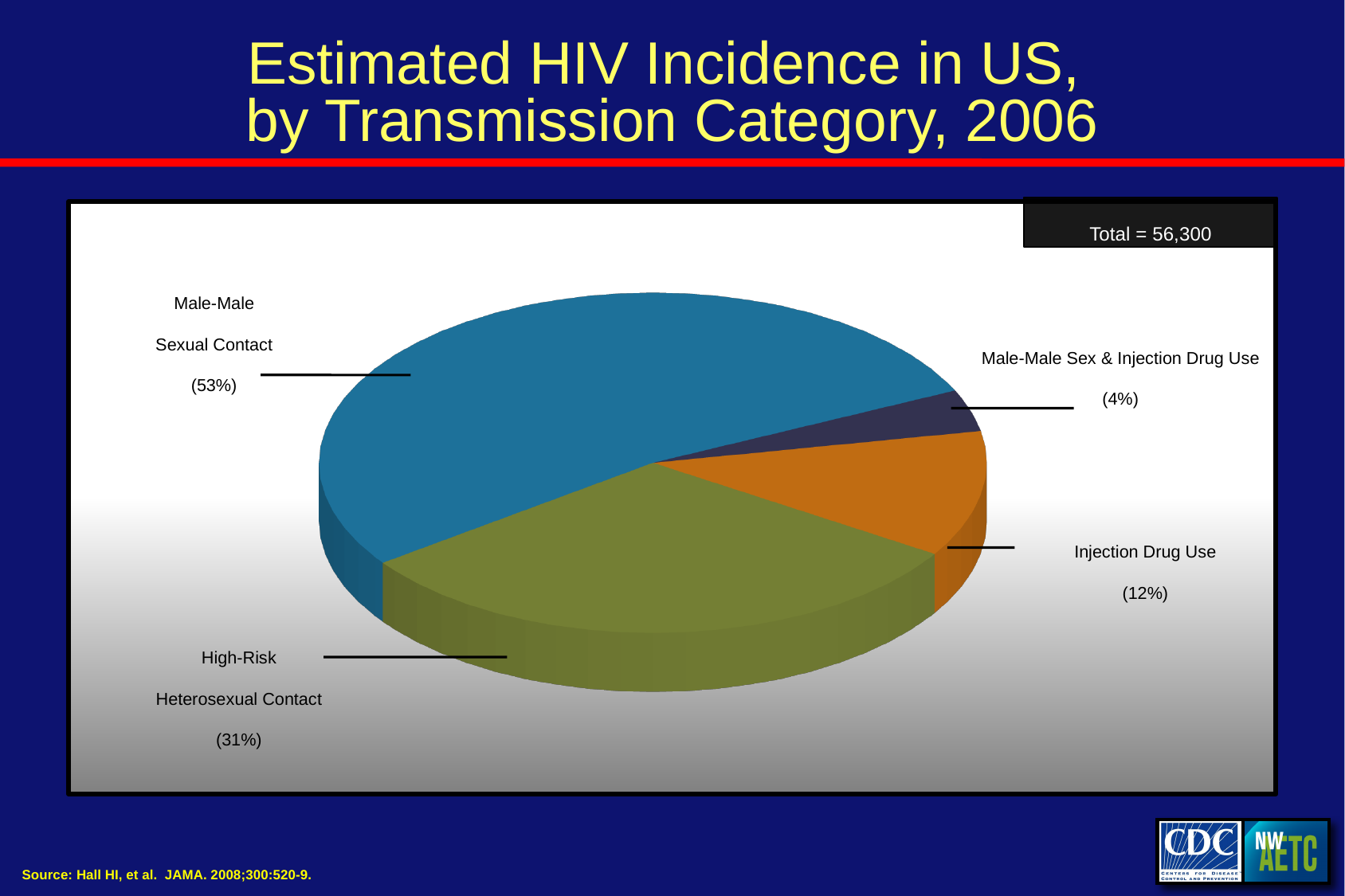
What kind of chart is shown on the slide? Pie chart What is the difference in percentage points between Male-Male Sexual Contact and High-Risk Heterosexual Contact? 22 percentage points What share of the pie is Injection Drug Use? 12% How many transmission categories are shown in the pie chart? 4 What is the title of the slide? Estimated HIV Incidence in US, by Transmission Category, 2006 What share of the pie is Male-Male Sexual Contact? 53% What share of the pie is High-Risk Heterosexual Contact? 31% Which transmission category has the largest share? Male-Male Sexual Contact Which is larger, the share for Injection Drug Use or the share for Male-Male Sex & Injection Drug Use? Injection Drug Use What total is shown in the box at the top right of the chart? Total = 56,300 Which transmission category has the smallest share? Male-Male Sex & Injection Drug Use